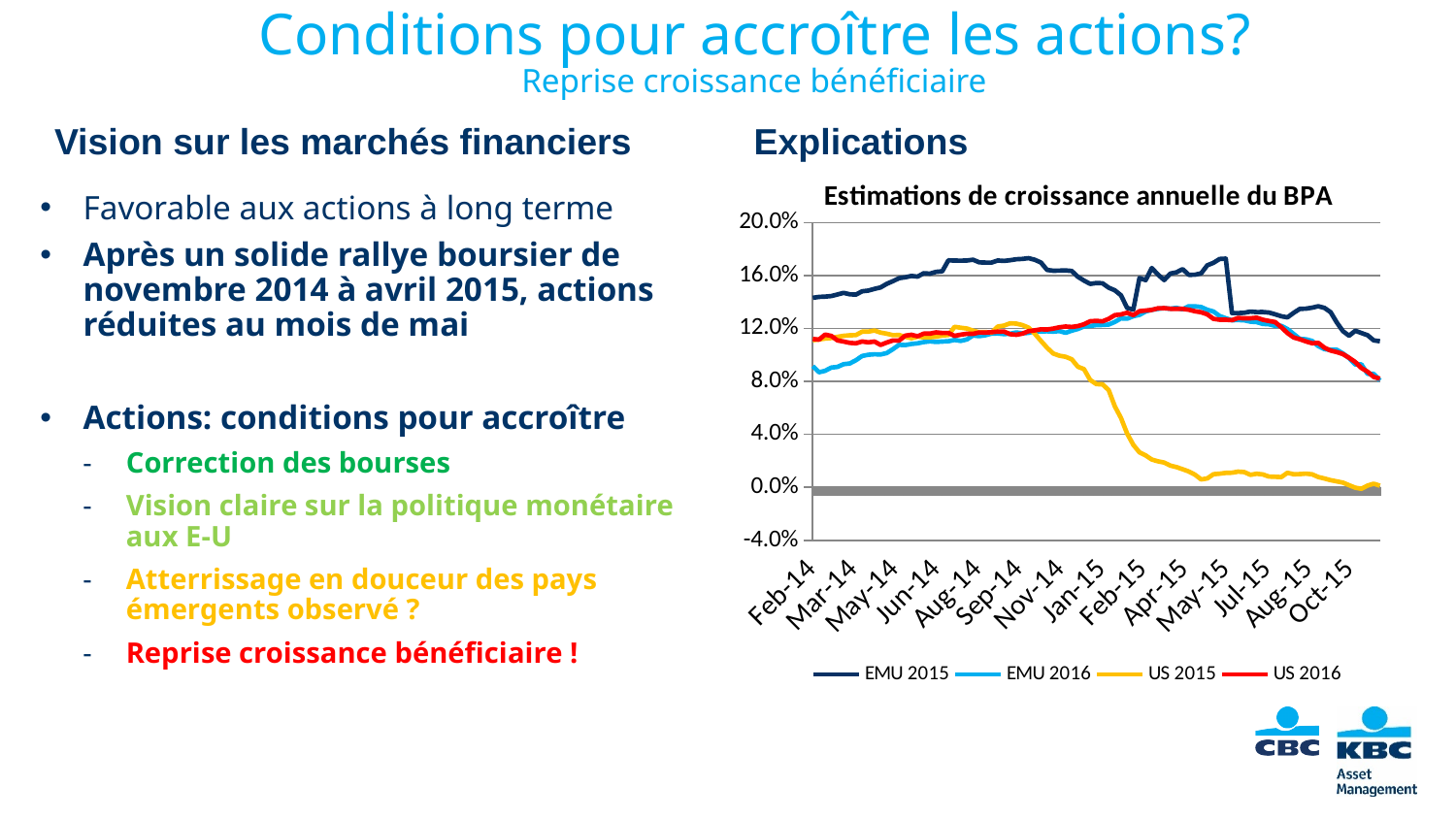
Does the EMU 2015 series rise or fall from May-15 to Oct-15? fall What is the title of the chart? Estimations de croissance annuelle du BPA Which series has the lowest value at Oct-15? US 2015 How many date labels are shown on the x axis of the chart? 14 At Feb-14, which is higher: EMU 2015 or US 2015? EMU 2015 Is the value of US 2015 at Jan-15 greater or less than 8.0%? less How many series does the chart legend list? 4 Is the value of EMU 2015 at Feb-14 greater or less than 12.0%? greater Is the value of US 2015 at Oct-15 greater or less than 4.0%? less Does the US 2015 series rise or fall overall from Feb-14 to Oct-15? fall Which series is drawn in red in the chart? US 2016 What kind of chart is shown on the slide? line chart